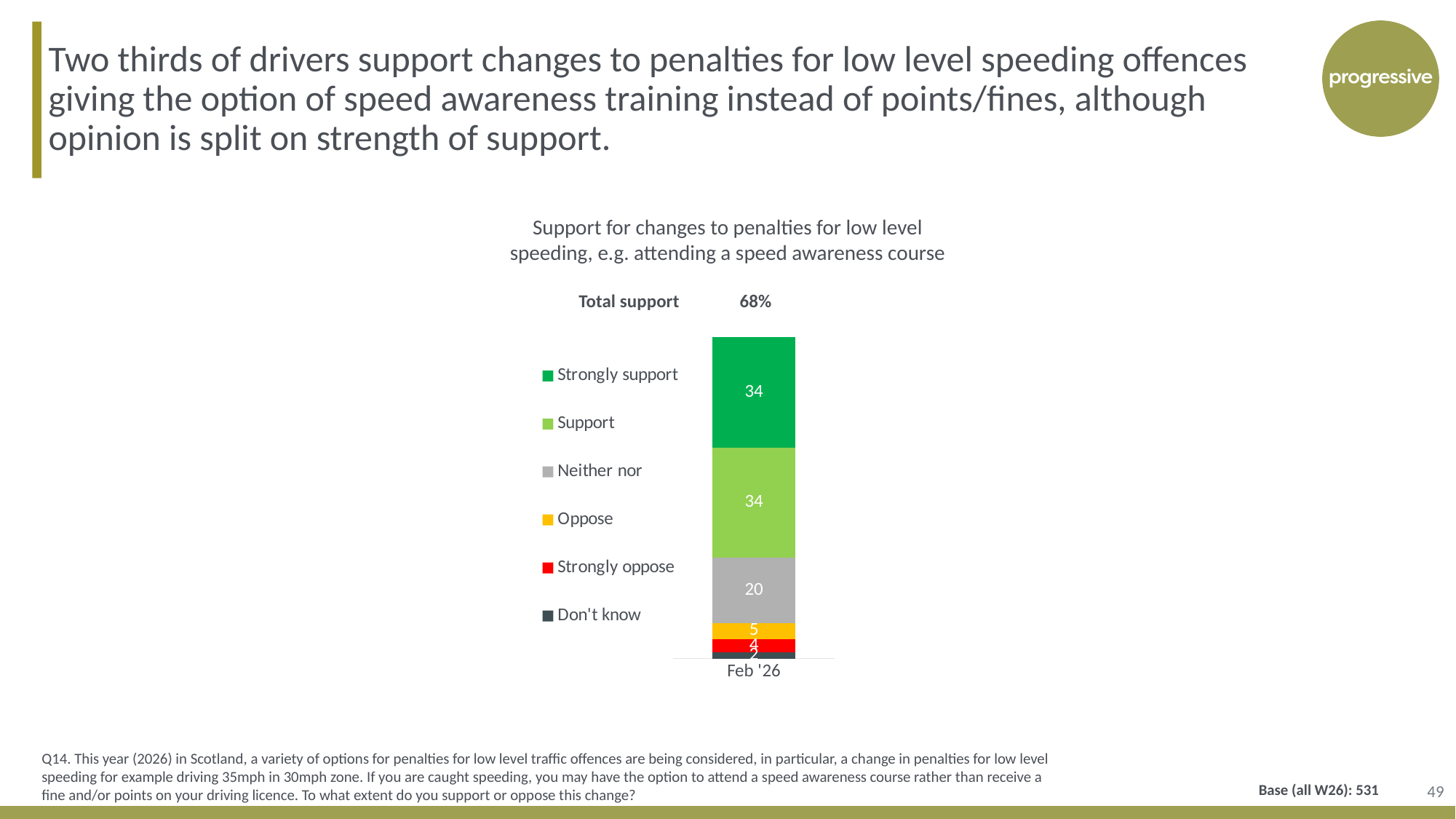
What is the Total support figure shown above the chart? 68% What is the value for Oppose in the Feb '26 bar? 5 What is the value for Neither nor in the Feb '26 bar? 20 Which series has the smallest value in the Feb '26 bar? Don't know How many series does the legend list? 6 Which is larger, the value for Oppose or the value for Strongly oppose? Oppose What is the title of the chart? Support for changes to penalties for low level speeding, e.g. attending a speed awareness course What is the value for Don't know in the Feb '26 bar? 2 What kind of chart is shown on the slide? Stacked bar chart What is the value for Strongly support in the Feb '26 bar? 34 What is the difference between the Neither nor value and the Oppose value? 15 What is the value for Strongly oppose in the Feb '26 bar? 4